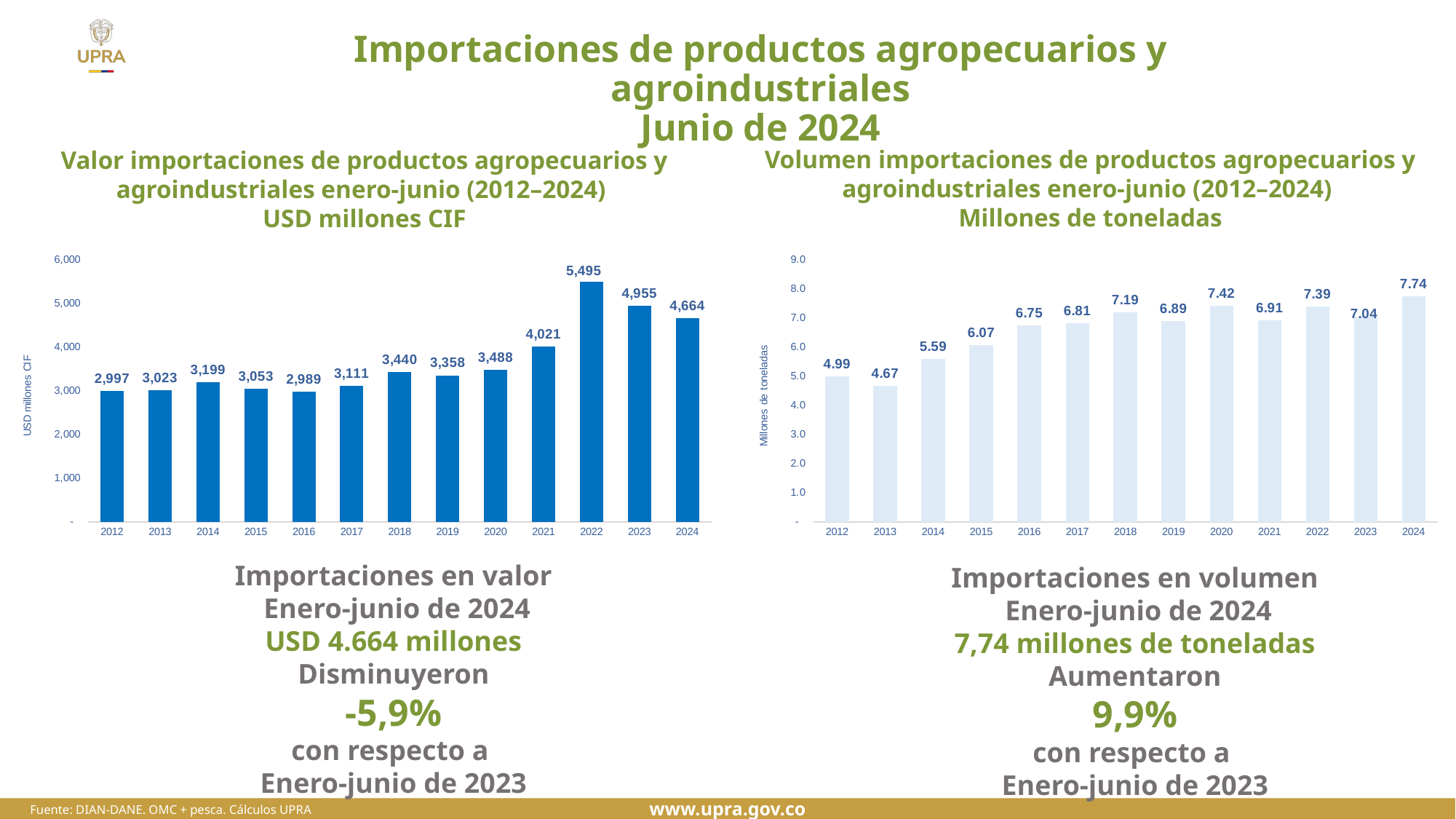
In the right chart (Volumen importaciones, Millones de toneladas), which year has the lowest value? 2013 In the right chart (Volumen importaciones, Millones de toneladas), which is larger, the value for 2018 or the value for 2019? 2018 In the left chart (Valor importaciones, USD millones CIF), which year has the lowest value? 2016 In the right chart (Volumen importaciones, Millones de toneladas), what is the difference between the 2024 and 2023 values? 0.70 In the left chart (Valor importaciones, USD millones CIF), how many years are plotted? 13 What kind of chart is the left chart (Valor importaciones, USD millones CIF)? bar chart In the right chart (Volumen importaciones, Millones de toneladas), what is the value for 2020? 7.42 In the left chart (Valor importaciones, USD millones CIF), is the value for 2021 greater or less than 4,000? greater In the left chart (Valor importaciones, USD millones CIF), what is the difference between the 2023 and 2024 values? 291 In the right chart (Volumen importaciones, Millones de toneladas), which year has the highest value? 2024 In the left chart (Valor importaciones, USD millones CIF), what is the value for 2022? 5,495 What is the y-axis label of the right chart (Volumen importaciones)? Millones de toneladas